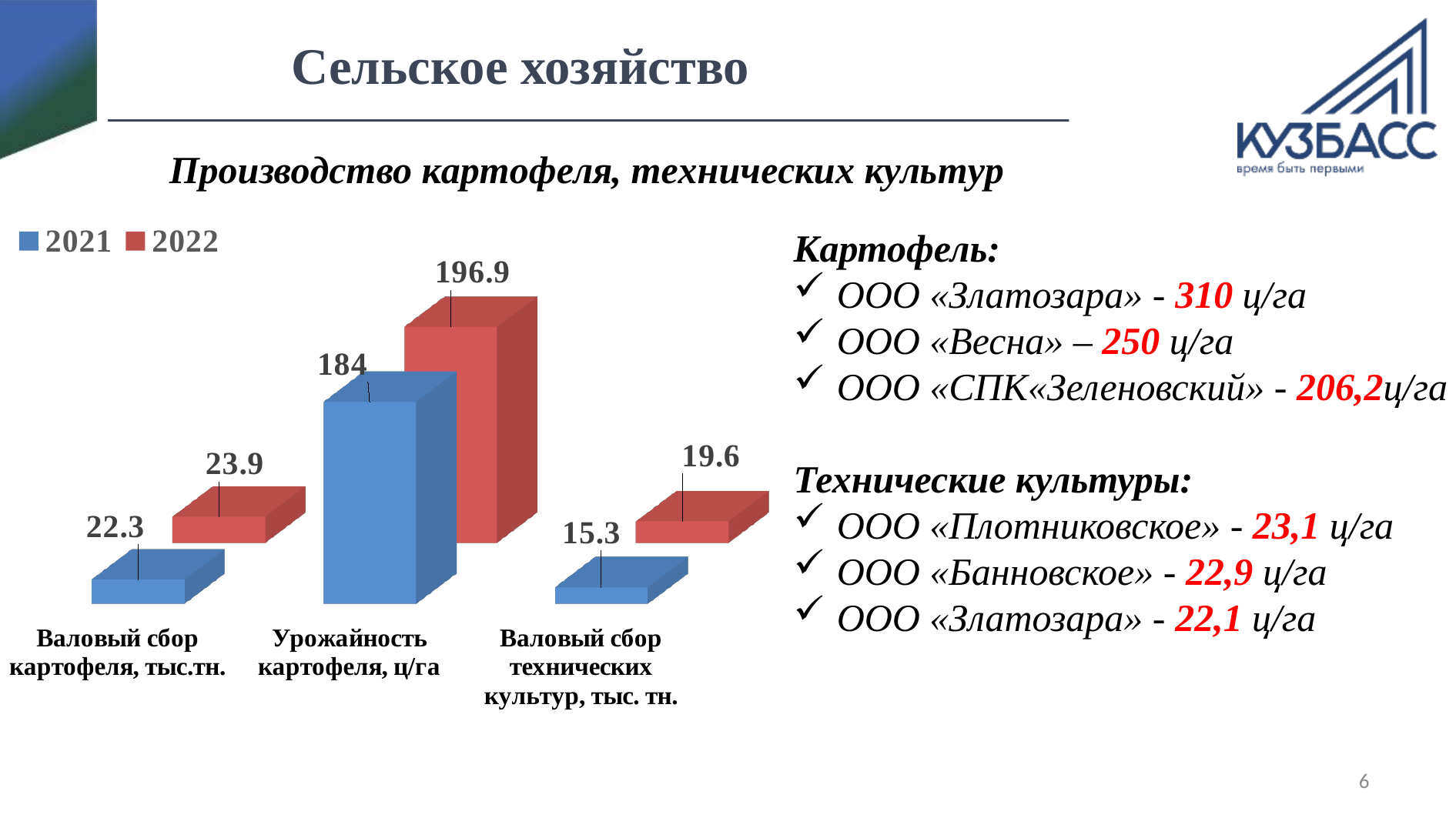
Which category has the lowest 2021 value? Валовый сбор технических культур, тыс. тн. Which is larger for Валовый сбор технических культур: the 2021 value or the 2022 value? 2022 What is the 2021 value for Урожайность картофеля, ц/га? 184 What is the 2021 value for Валовый сбор картофеля, тыс.тн.? 22.3 Which category has the highest 2022 value? Урожайность картофеля, ц/га What is the 2022 value for Валовый сбор картофеля, тыс.тн.? 23.9 What kind of chart is shown on the slide? Bar chart What is the 2022 value for Валовый сбор технических культур, тыс. тн.? 19.6 How many series does the legend list? 2 What is the 2021 value for Валовый сбор технических культур, тыс. тн.? 15.3 What is the 2022 value for Урожайность картофеля, ц/га? 196.9 What is the difference between the 2022 and 2021 values for Урожайность картофеля, ц/га? 12.9